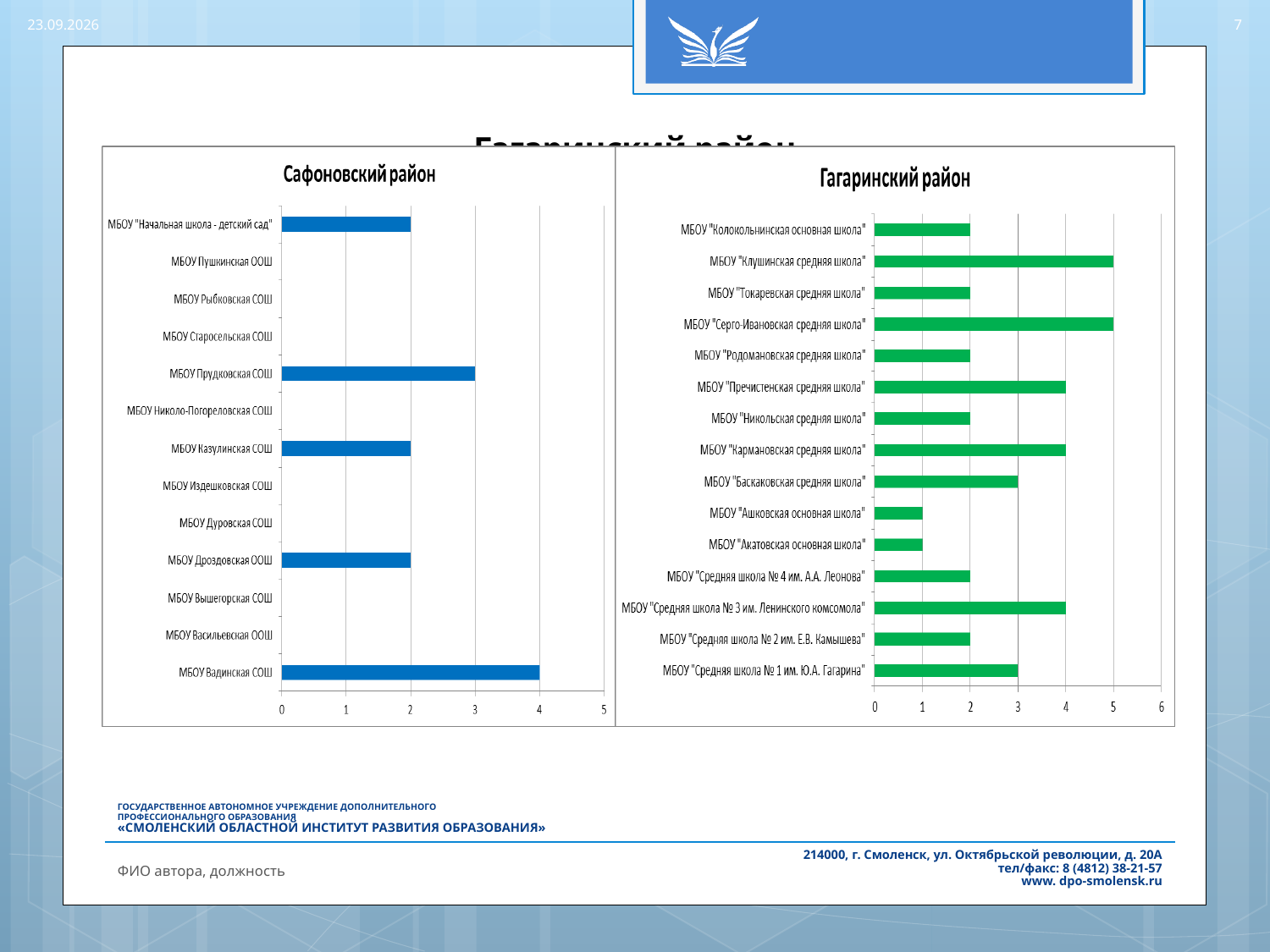
In the "Гагаринский район" chart, what is the difference between the values for МБОУ "Серго-Ивановская средняя школа" and МБОУ "Акатовская основная школа"? 4 In the "Сафоновский район" chart, what is the value for МБОУ Вадинская СОШ? 4 In the "Сафоновский район" chart, how many schools are listed on the vertical axis? 13 What type of chart is used for the "Сафоновский район" chart? bar chart In the "Сафоновский район" chart, which school has the highest value? МБОУ Вадинская СОШ In the "Гагаринский район" chart, how many schools are listed on the vertical axis? 15 In the "Гагаринский район" chart, what is the value for МБОУ "Ашковская основная школа"? 1 In the "Гагаринский район" chart, what is the value for МБОУ "Баскаковская средняя школа"? 3 In the "Сафоновский район" chart, what is the difference between the values for МБОУ Вадинская СОШ and МБОУ Казулинская СОШ? 2 In the "Гагаринский район" chart, what is the value for МБОУ "Клушинская средняя школа"? 5 In the "Сафоновский район" chart, what is the value for МБОУ Прудковская СОШ? 3 In the "Гагаринский район" chart, which is larger: the value for МБОУ "Пречистенская средняя школа" or МБОУ "Никольская средняя школа"? МБОУ "Пречистенская средняя школа"